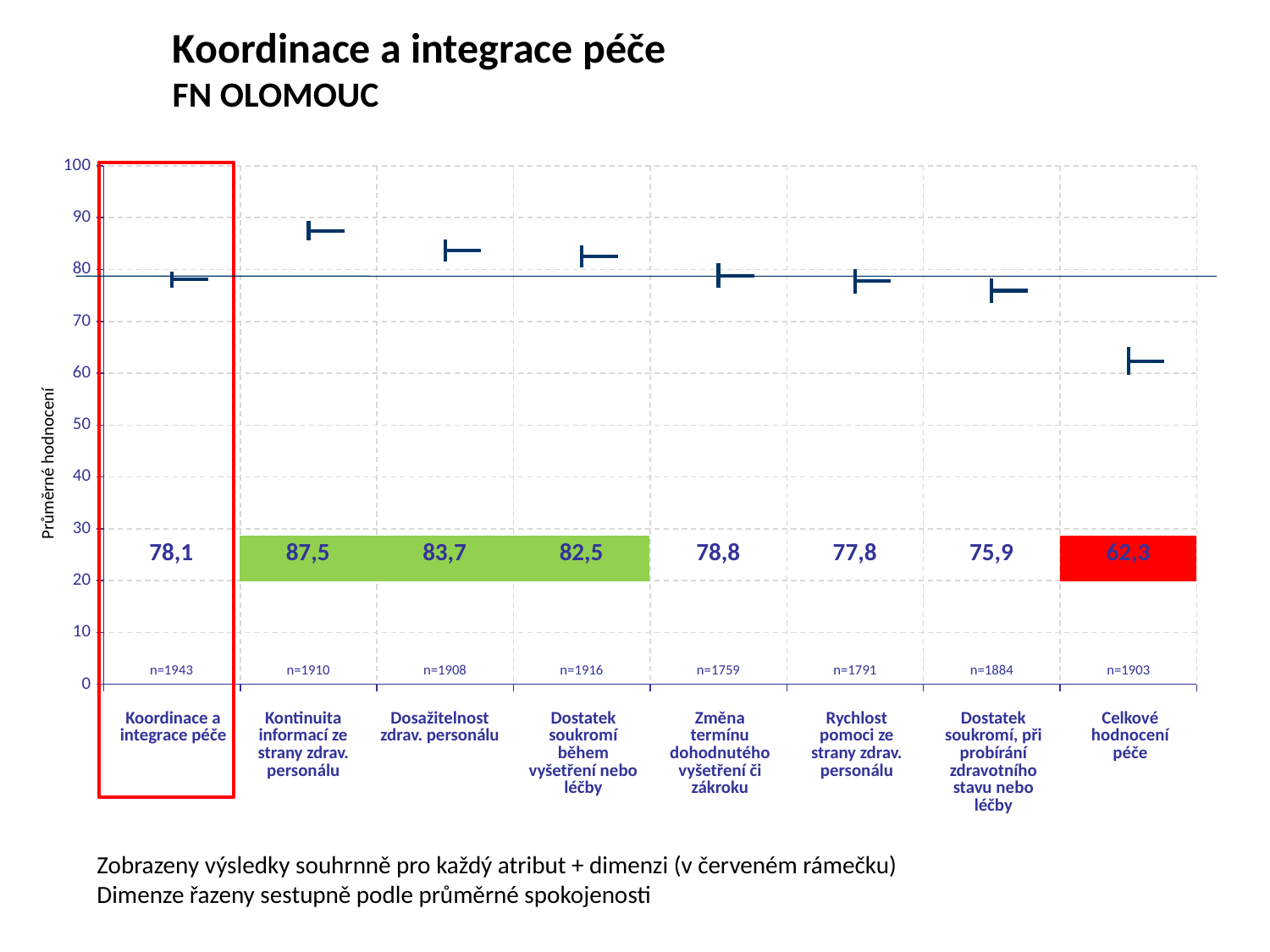
How many categories are shown on the x axis? 8 Which category has the lowest value? Celkové hodnocení péče What is the value for Kontinuita informací ze strany zdrav. personálu? 87,5 What is the sample size (n) shown for Změna termínu dohodnutého vyšetření či zákroku? n=1759 What is the label of the y axis? Průměrné hodnocení Which category has the highest value? Kontinuita informací ze strany zdrav. personálu What is the value for Koordinace a integrace péče? 78,1 What is the difference between the values for Kontinuita informací ze strany zdrav. personálu and Celkové hodnocení péče? 25,2 What is the value for Dostatek soukromí během vyšetření nebo léčby? 82,5 What is the value for Celkové hodnocení péče? 62,3 Which category is highlighted with a red box? Koordinace a integrace péče Which is larger, the value for Dosažitelnost zdrav. personálu or the value for Rychlost pomoci ze strany zdrav. personálu? Dosažitelnost zdrav. personálu